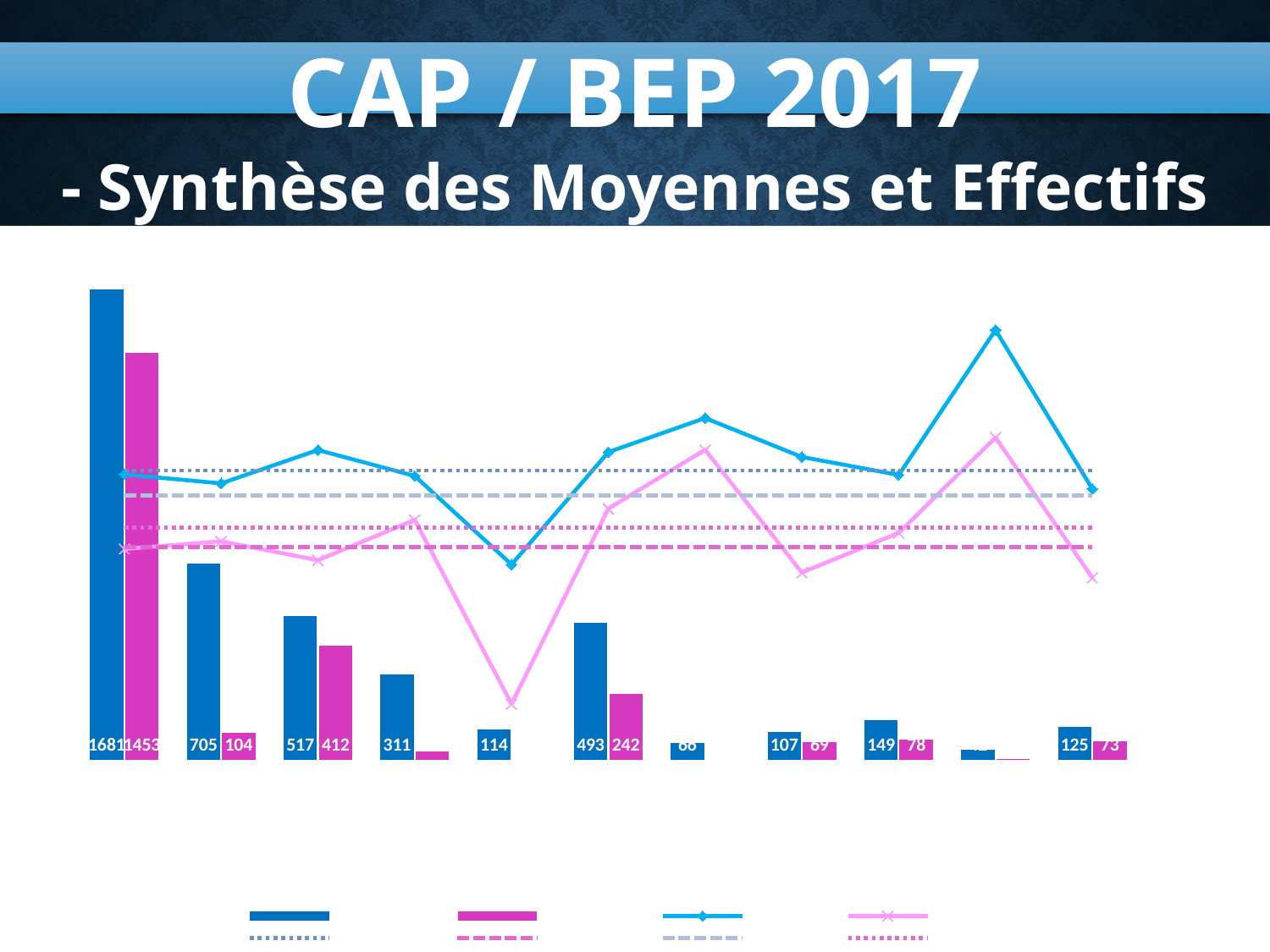
What is the difference between the blue bar (1681) and the magenta bar (1453) in the first group? 228 What is the value printed on the blue bar in the second group of bars? 705 In the third group of bars, which is larger: the blue bar (517) or the magenta bar (412)? The blue bar (517) What is the value printed on the magenta bar in the first group of bars? 1453 How many entries does the legend at the bottom of the slide show? 8 Does the light blue line rise or fall from its tenth point to its eleventh (last) point? Fall What is the value printed on the magenta bar in the sixth group of bars (next to the blue bar labelled 493)? 242 What is the difference between the blue bar (705) and the magenta bar (104) in the second group? 601 What is the title shown at the top of the slide? CAP / BEP 2017 - Synthèse des Moyennes et Effectifs What kind of chart is shown on the slide? A combined bar and line chart How many groups of bars are plotted along the x axis? 11 What is the value printed on the tallest blue bar? 1681